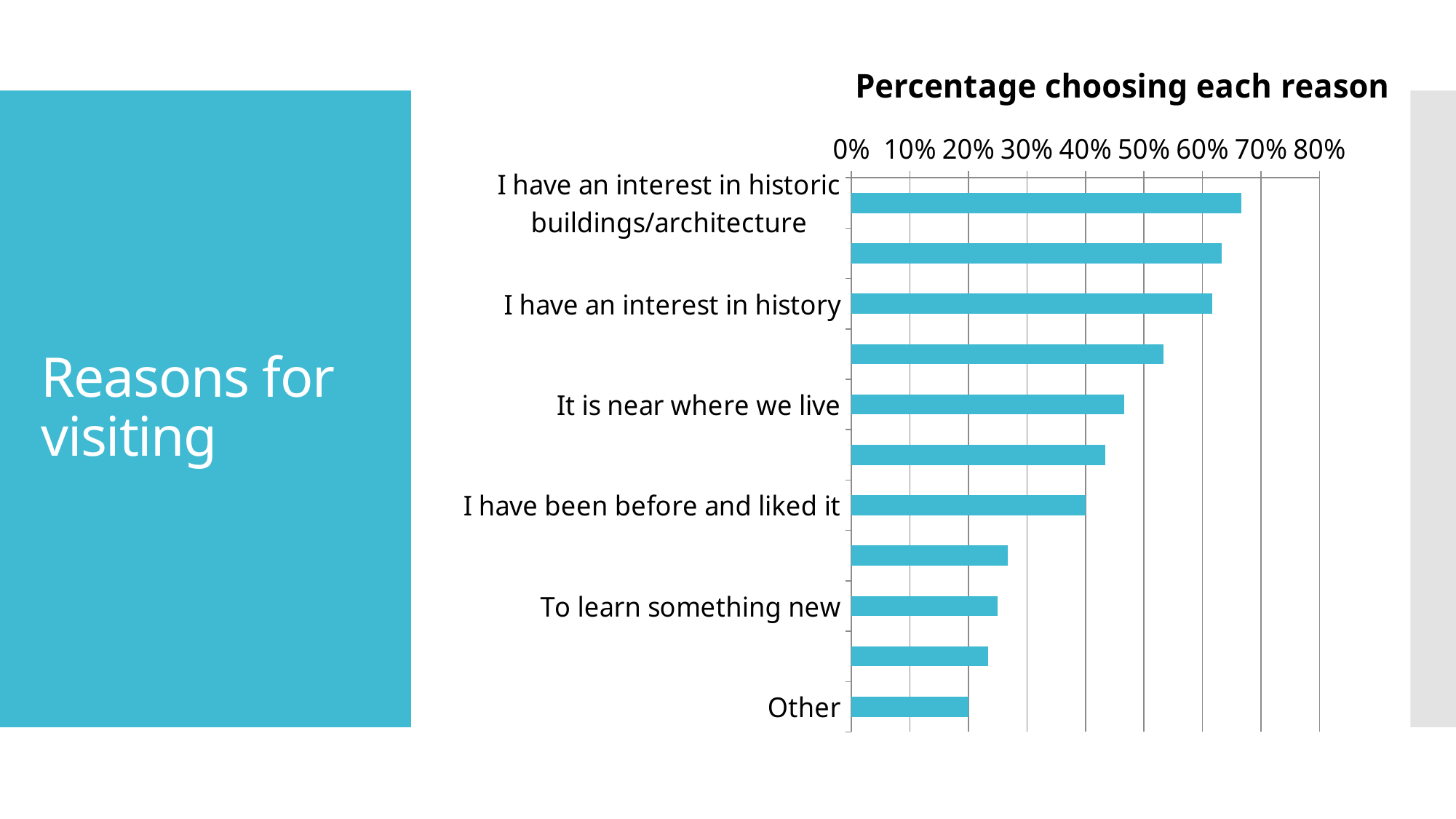
Is the value for 'I have an interest in historic buildings/architecture' greater or less than 60%? greater What is the title of the chart? Percentage choosing each reason Is the value for 'I have an interest in history' greater or less than 50%? greater Which is larger, the value for 'It is near where we live' or the value for 'To learn something new'? It is near where we live How many bars are plotted in the chart? 11 Is the value for 'To learn something new' greater or less than 30%? less What kind of chart is shown on the slide? bar chart Which labelled reason has the shortest bar? Other Which labelled reason has the longest bar? I have an interest in historic buildings/architecture Do the bar values increase or decrease going from the top of the chart to the bottom? decrease